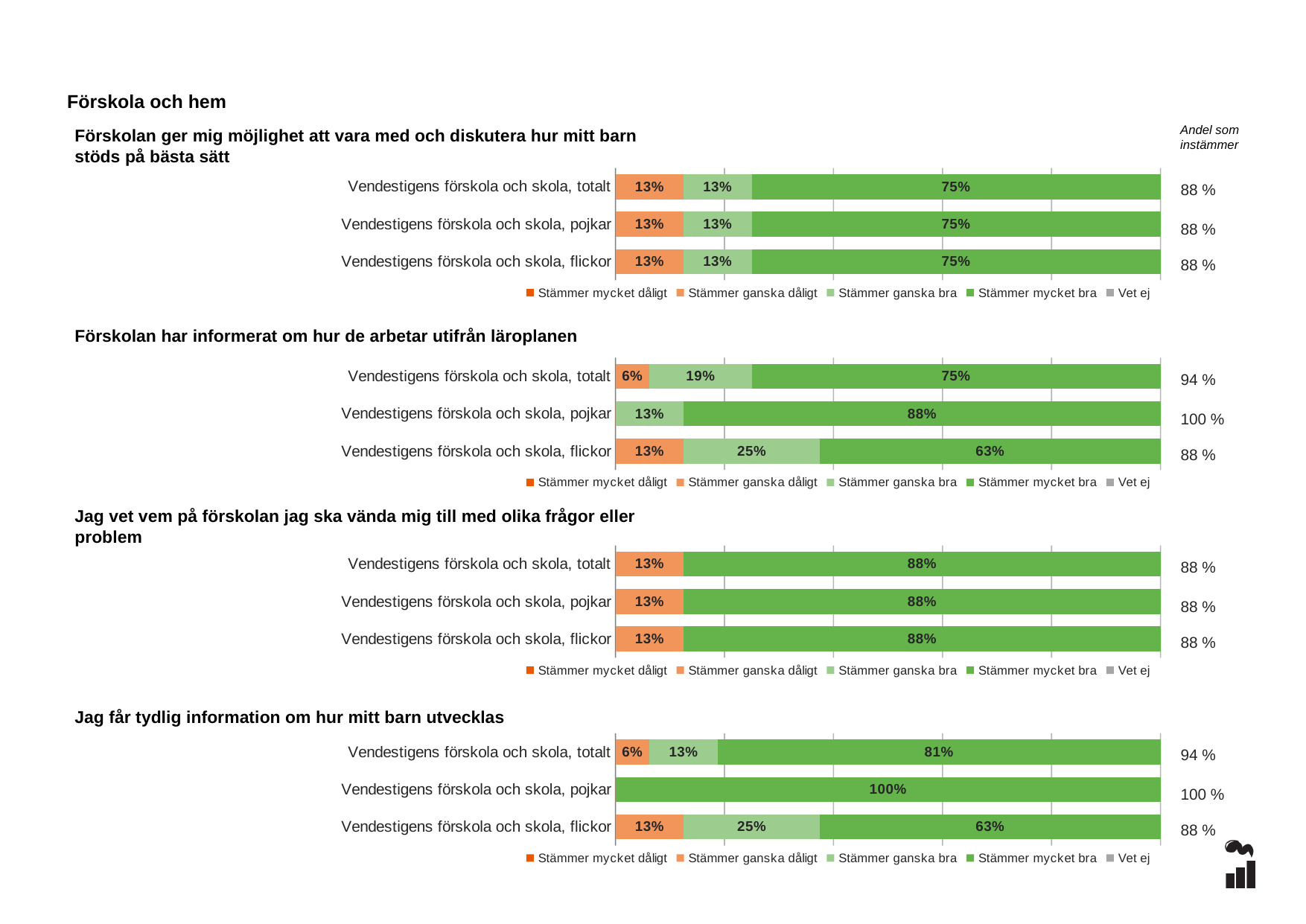
In the chart 'Jag får tydlig information om hur mitt barn utvecklas', what is the 'Stämmer mycket bra' value for Vendestigens förskola och skola, pojkar? 100% In the chart 'Förskolan har informerat om hur de arbetar utifrån läroplanen', which row has the highest 'Stämmer mycket bra' value? Vendestigens förskola och skola, pojkar In the chart 'Förskolan har informerat om hur de arbetar utifrån läroplanen', what is the 'Stämmer ganska bra' value for Vendestigens förskola och skola, flickor? 25% How many series does the legend of the chart 'Förskolan ger mig möjlighet att vara med och diskutera hur mitt barn stöds på bästa sätt' list? 5 In the chart 'Förskolan ger mig möjlighet att vara med och diskutera hur mitt barn stöds på bästa sätt', what is the 'Stämmer mycket bra' value for Vendestigens förskola och skola, totalt? 75% How many rows (categories) does the chart 'Jag vet vem på förskolan jag ska vända mig till med olika frågor eller problem' show? 3 In the chart 'Förskolan har informerat om hur de arbetar utifrån läroplanen', what is the 'Stämmer mycket bra' value for Vendestigens förskola och skola, pojkar? 88% In the chart 'Jag får tydlig information om hur mitt barn utvecklas', which row has the lowest 'Stämmer mycket bra' value? Vendestigens förskola och skola, flickor What kind of chart is used for 'Jag vet vem på förskolan jag ska vända mig till med olika frågor eller problem'? Stacked bar chart In the chart 'Jag får tydlig information om hur mitt barn utvecklas', what is the 'Stämmer mycket bra' value for Vendestigens förskola och skola, totalt? 81% In the chart 'Förskolan har informerat om hur de arbetar utifrån läroplanen', what is the difference between the 'Stämmer mycket bra' values for pojkar and flickor? 25% In the chart 'Jag får tydlig information om hur mitt barn utvecklas', is the 'Stämmer mycket bra' value larger for totalt or for flickor? totalt